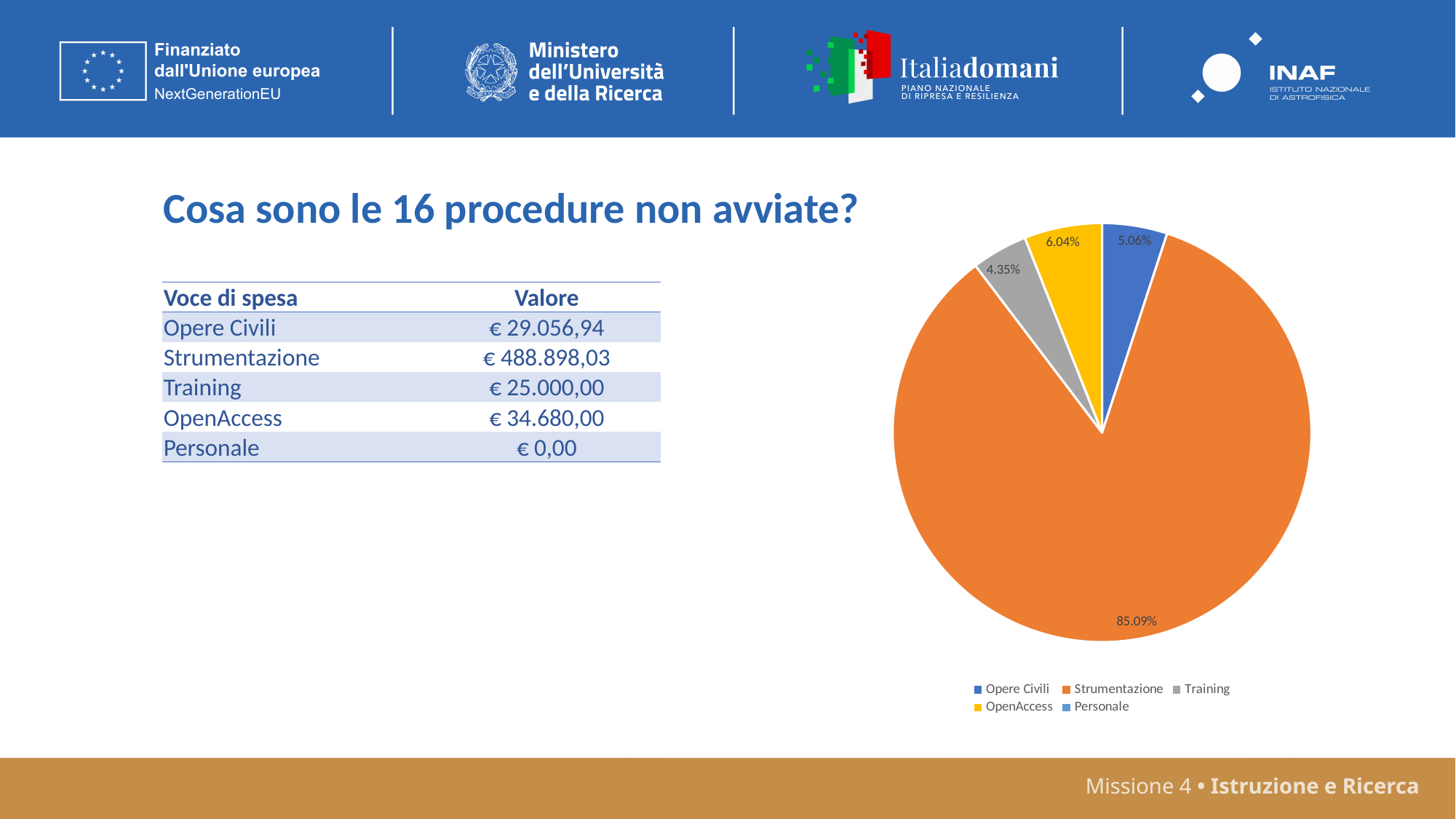
Which is larger, the OpenAccess slice or the Opere Civili slice? OpenAccess Among the slices with a printed percentage, which category has the smallest share? Training What percentage is shown for the Opere Civili slice? 5.06% What percentage is shown for the OpenAccess slice? 6.04% What is the difference in percentage points between the Strumentazione slice and the Opere Civili slice? 80.03% How many categories does the pie chart legend list? 5 Which legend entry is shown in yellow? OpenAccess What percentage is shown for the Training slice? 4.35% What colour is the Strumentazione slice in the pie chart? orange What share of the pie does Strumentazione represent? 85.09% What kind of chart is shown on the slide? pie chart Which category has the largest slice of the pie? Strumentazione